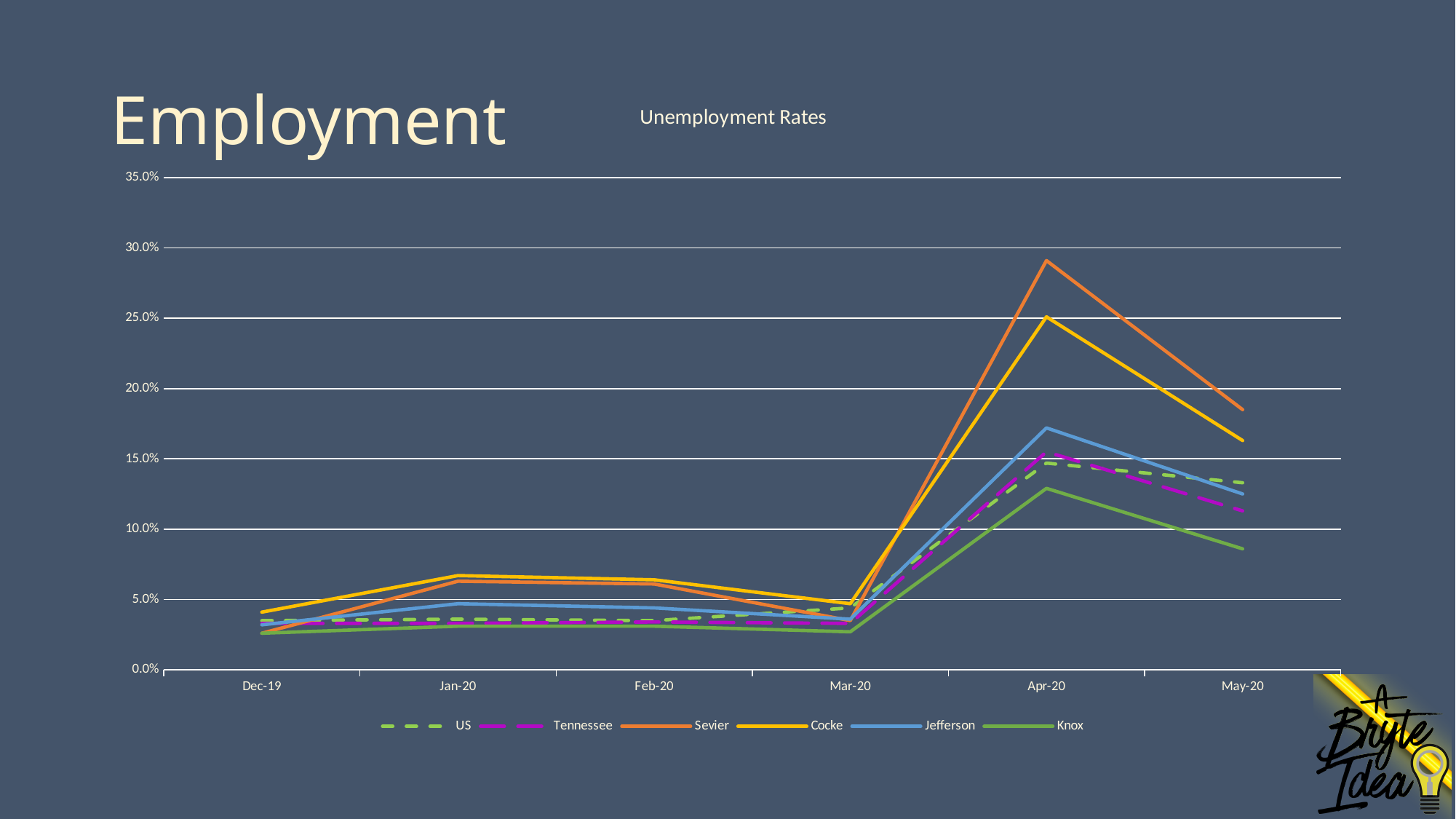
Which is larger in May-20, the value for Sevier or the value for Cocke? Sevier Which two series are drawn with dashed lines? US and Tennessee What kind of chart is shown on the slide? line chart How many series does the legend list? 6 Does the Sevier line rise or fall from Apr-20 to May-20? fall Is the value for Cocke in Apr-20 greater or less than 20.0%? greater What is the title of the chart? Unemployment Rates Which series has the highest unemployment rate in Apr-20? Sevier How many months are shown along the x axis? 6 Is the value for Knox in May-20 greater or less than 10.0%? less Is the value for Sevier in Apr-20 greater or less than 25.0%? greater Which series has the lowest unemployment rate in Apr-20? Knox